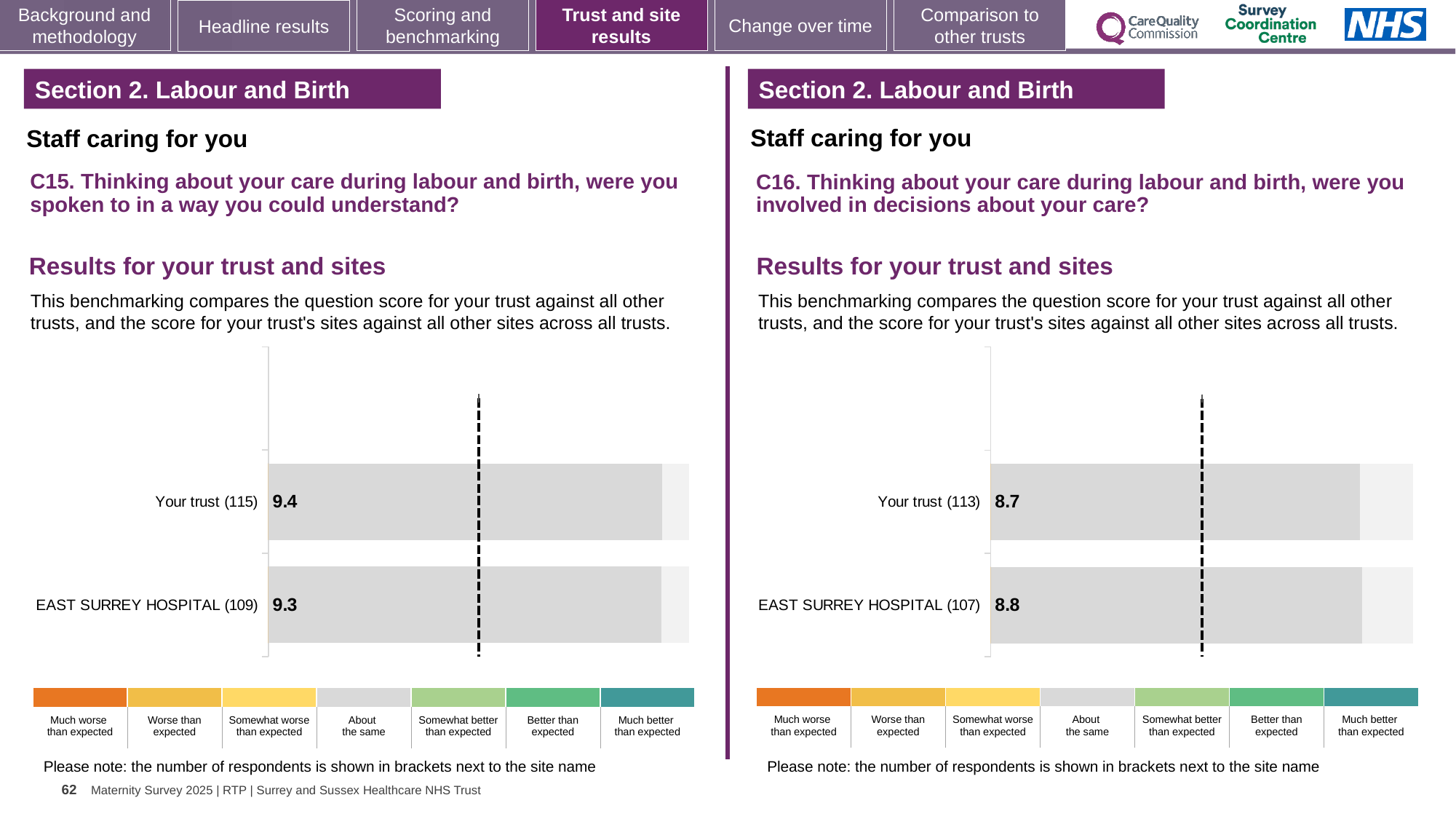
In the C16 chart on the right, what is the score for EAST SURREY HOSPITAL? 8.8 How many bars are plotted in the C15 chart on the left? 2 In the C16 chart on the right, what is the score for Your trust? 8.7 In the C15 chart on the left, what is the score for EAST SURREY HOSPITAL? 9.3 In the C15 chart on the left, which bar has the higher score? Your trust In the C15 chart on the left, what is the score for Your trust? 9.4 In the C15 chart on the left, what is the difference between the Your trust score and the EAST SURREY HOSPITAL score? 0.1 In the C16 chart on the right, is the score for EAST SURREY HOSPITAL higher or lower than the score for Your trust? higher In the C16 chart on the right, how many respondents are shown in brackets for EAST SURREY HOSPITAL? 107 What type of chart is used in the C16 chart on the right? bar chart In the C15 chart on the left, how many respondents are shown in brackets for Your trust? 115 In the C16 chart on the right, which bar has the lower score? Your trust